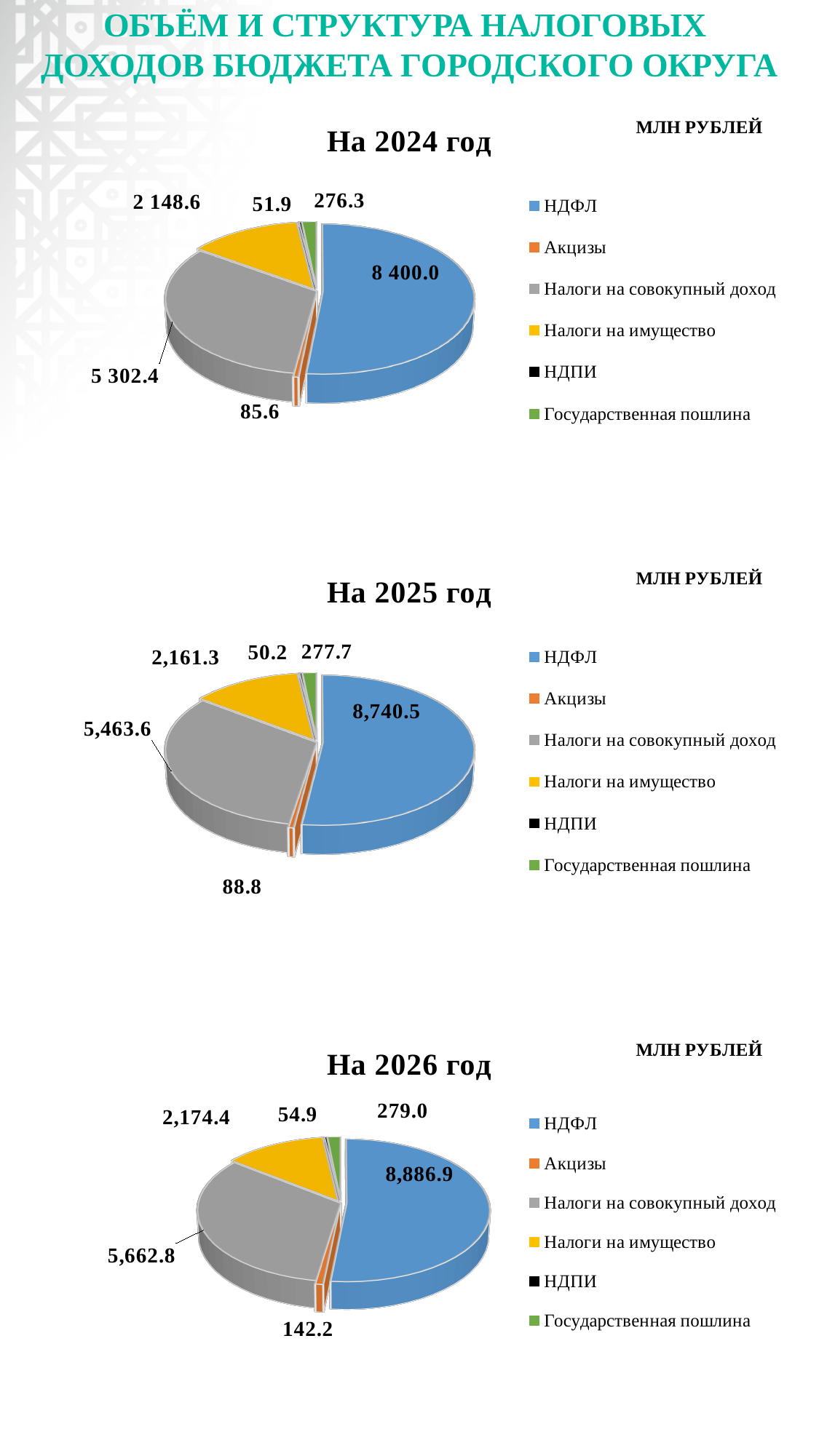
In the "На 2025 год" chart, which category has the largest value? НДФЛ In the "На 2024 год" chart, which category has the smallest value? НДПИ In the "На 2024 год" chart, what is the difference between НДФЛ and Налоги на совокупный доход? 3 097.6 In the "На 2024 год" chart, what is the value for Налоги на имущество? 2 148.6 In the "На 2024 год" chart, what is the value for НДФЛ? 8 400.0 What kind of chart is used for "На 2024 год"? Pie chart In the "На 2026 год" chart, what is the value for Акцизы? 142.2 In the "На 2025 год" chart, which is larger: Акцизы or Государственная пошлина? Государственная пошлина In the "На 2026 год" chart, what is the value for НДПИ? 54.9 What unit is stated above the legend of each chart? МЛН РУБЛЕЙ In the "На 2025 год" chart, what is the value for Налоги на совокупный доход? 5,463.6 How many categories does the legend of the "На 2026 год" chart list? 6